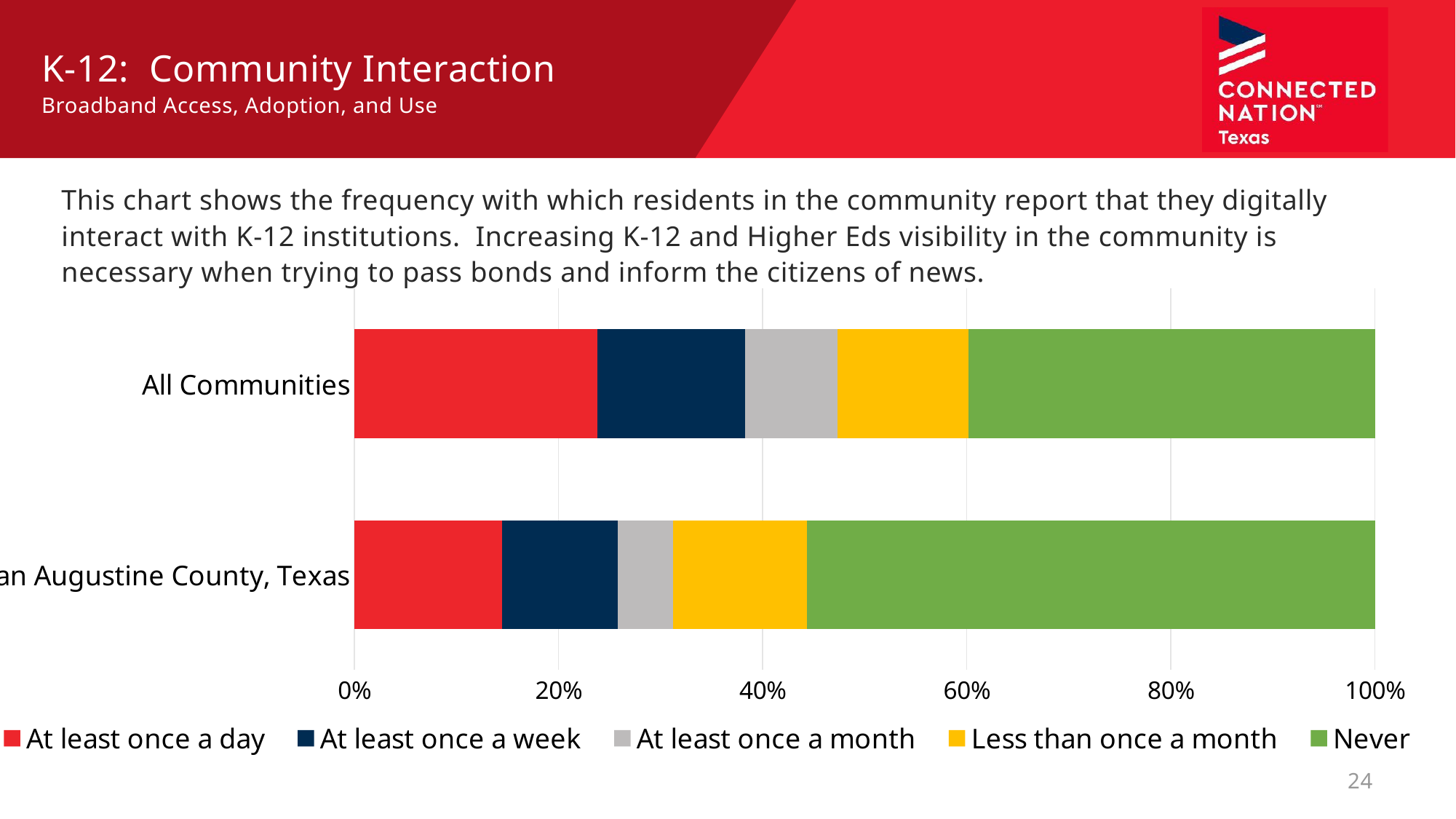
Which series is shown in red in the legend? At least once a day What is the total of the stacked bar for All Communities? 100% What kind of chart is shown on the slide? Bar chart Which category has the larger 'At least once a day' share: All Communities or San Augustine County, Texas? All Communities Is the 'At least once a day' value for All Communities greater or less than 20%? greater How many series does the legend list? 5 Is the 'At least once a day' value for San Augustine County, Texas greater or less than 20%? less Is the 'Never' value for San Augustine County, Texas greater or less than 40%? greater Which series is shown in green in the legend? Never What is the highest value shown on the x axis? 100% How many categories (bars) does the chart show? 2 Which category has the larger 'Never' share: All Communities or San Augustine County, Texas? San Augustine County, Texas